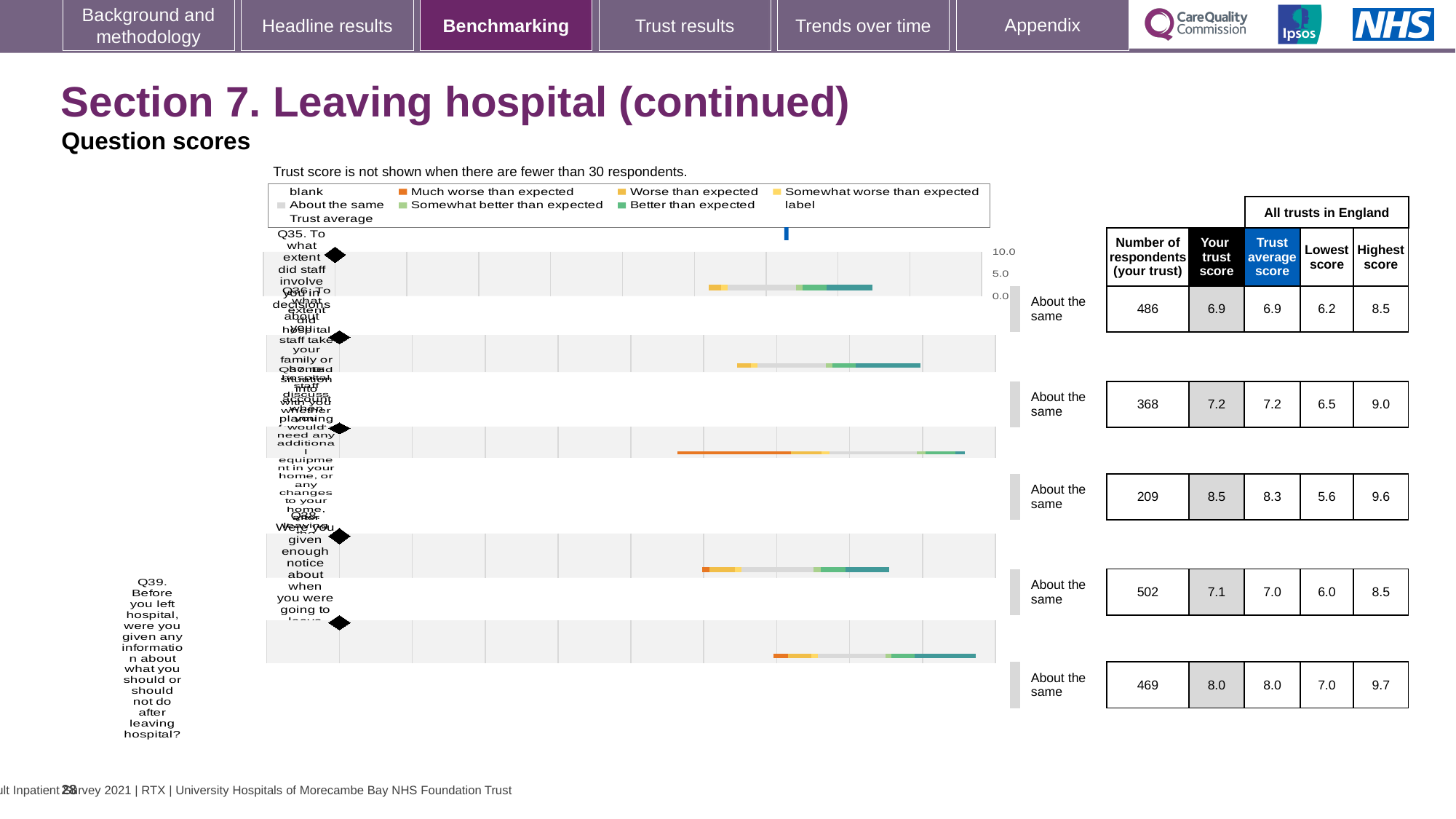
Is the trust score for Q36 higher or lower than the trust score for Q39? lower What is the trust score for Q35 (To what extent did staff involve you in decisions about you leaving hospital)? 6.9 What is the difference between the trust score and the trust average score for Q37? 0.2 What is the trust average score for Q36? 7.2 What kind of chart is used to show the question scores? Bar chart How many respondents answered Q38 (Were you given enough notice about when you were going to leave hospital)? 502 What is the highest score across all trusts in England for Q39? 9.7 How many questions are shown in the chart? 5 What is the lowest score across all trusts in England for Q37? 5.6 Which question has the fewest respondents for this trust? Q37 What benchmark category is shown for Q38? About the same Which question has the highest trust score for this trust? Q37